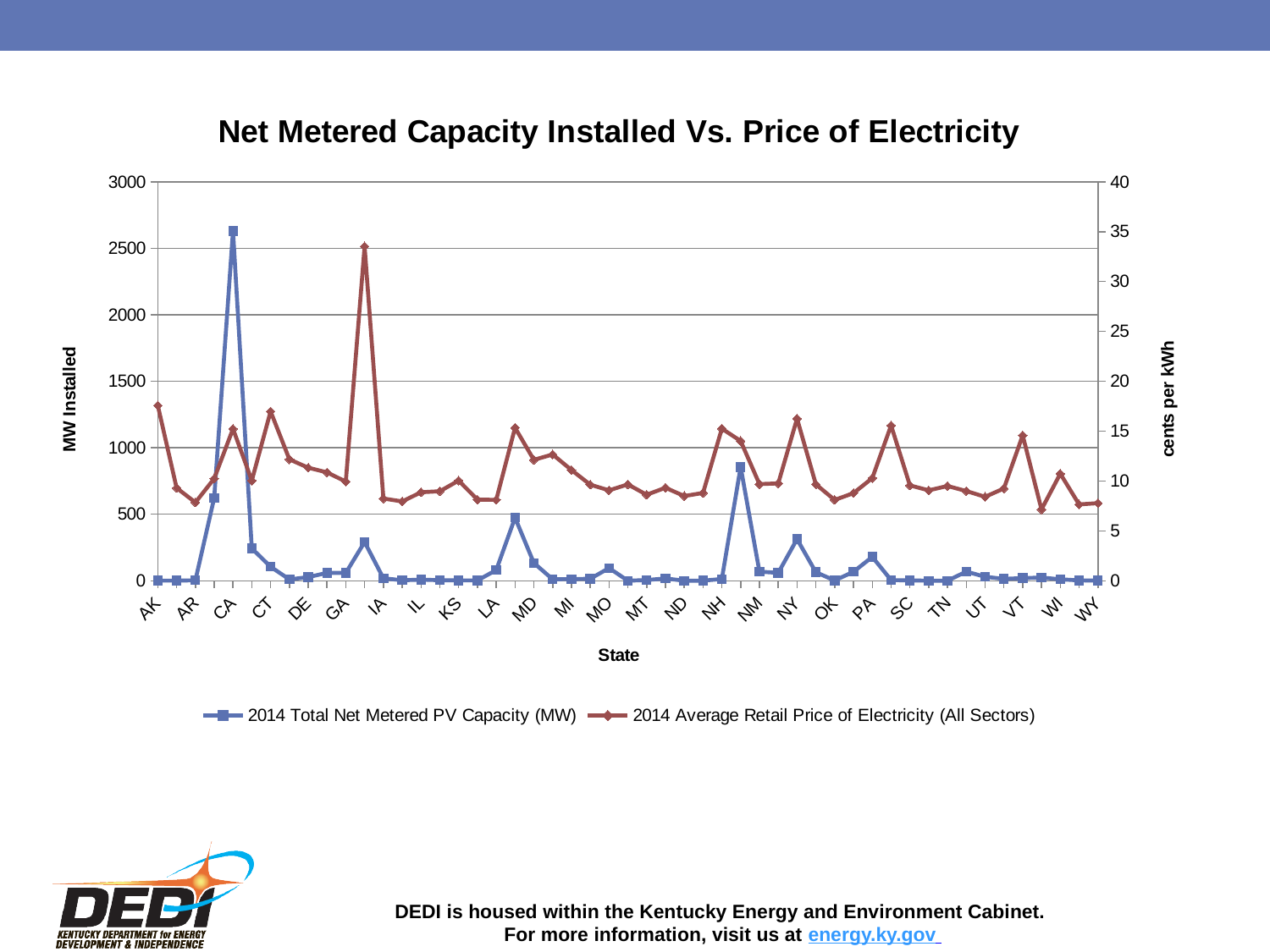
Is the 2014 Total Net Metered PV Capacity (MW) for NH greater or less than 500? less What is the title of the chart? Net Metered Capacity Installed Vs. Price of Electricity How many series does the legend list? 2 Which state has the larger 2014 Total Net Metered PV Capacity (MW), CA or NY? CA Is the 2014 Average Retail Price of Electricity for AK greater or less than 15? greater Is the 2014 Average Retail Price of Electricity for WY greater or less than 10? less What kind of chart is shown on the slide? line chart What is the label on the right-hand vertical axis? cents per kWh Which state has the highest 2014 Total Net Metered PV Capacity (MW)? CA Which state has the higher 2014 Average Retail Price of Electricity, AK or WY? AK